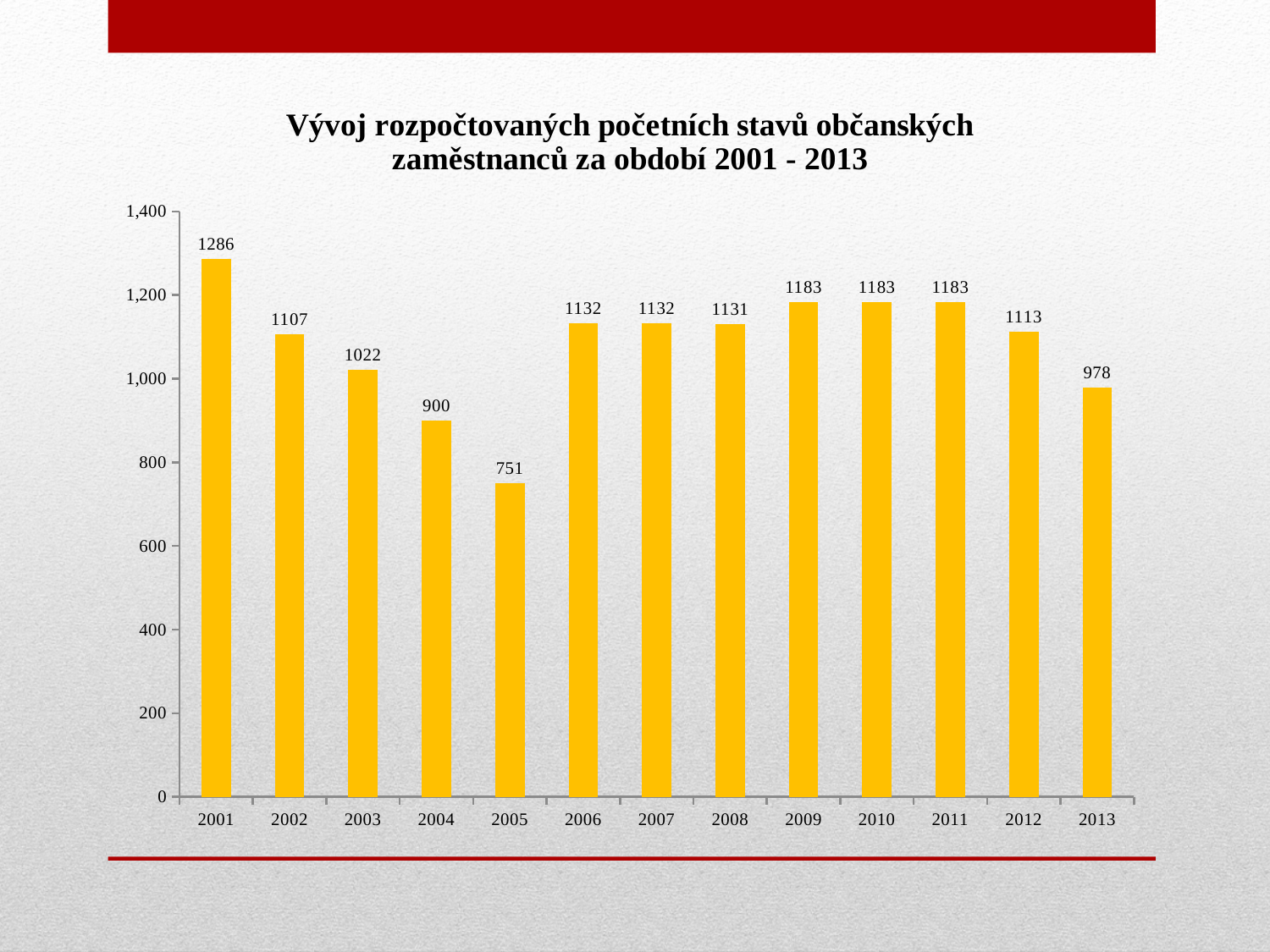
How many years are shown on the x axis? 13 Which year has the lowest value? 2005 Is the value for 2005 greater or less than 800? less What is the value for 2005? 751 Do the values rise or fall from 2001 to 2005? fall What is the value for 2013? 978 What is the value for 2001? 1286 What is the difference between the values for 2012 and 2013? 135 Which year has the highest value? 2001 Which is larger, the value for 2003 or the value for 2004? 2003 What kind of chart is shown on the slide? bar chart What is the difference between the values for 2001 and 2005? 535